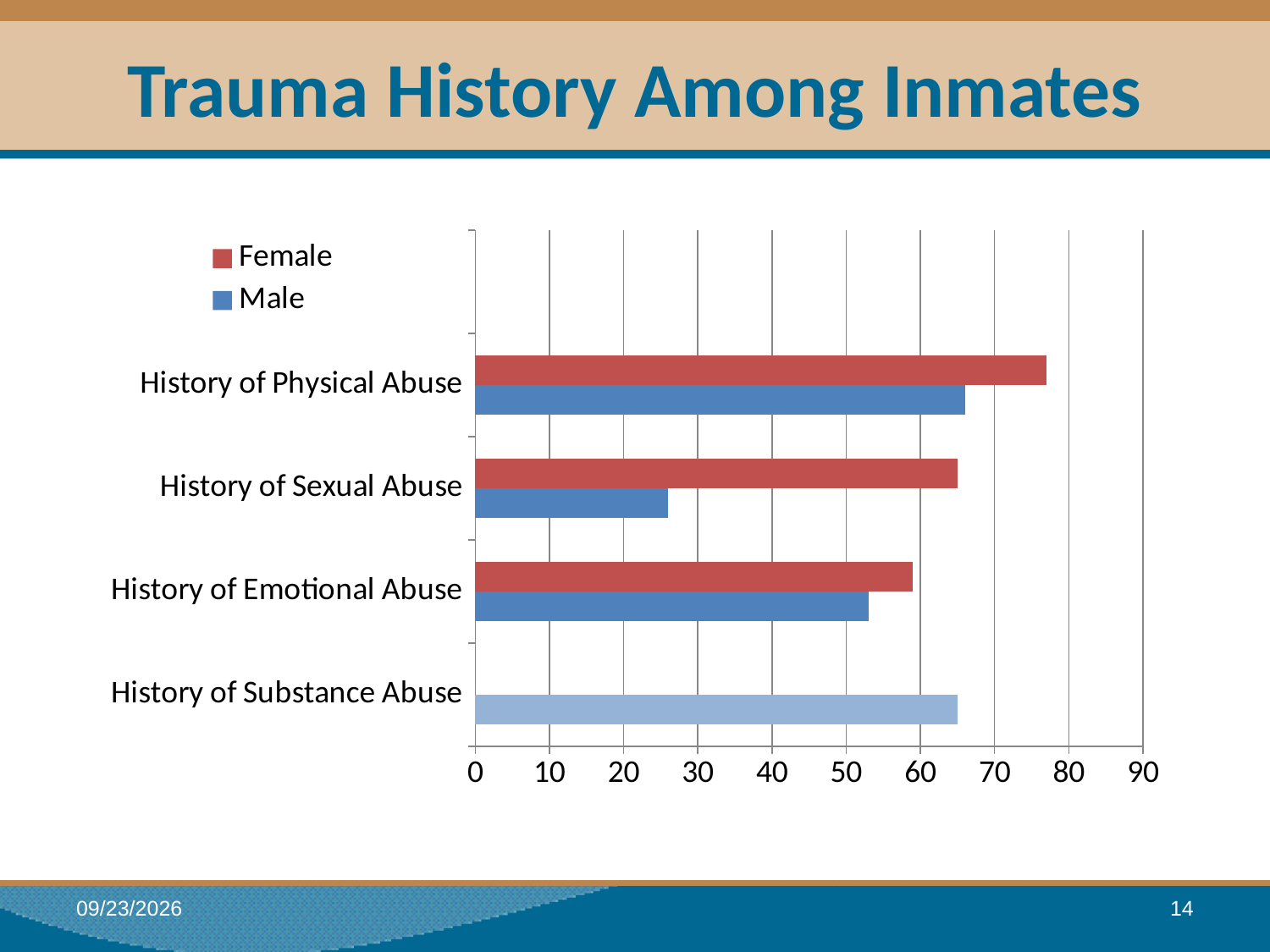
How many series does the legend list? 2 For History of Sexual Abuse, which is larger, the Female value or the Male value? Female Which category has the lowest Male value? History of Sexual Abuse Is the Female value for History of Physical Abuse greater or less than 70? greater For History of Physical Abuse, which is larger, the Female value or the Male value? Female What type of chart is shown on the slide? bar chart Which category has the highest Female value? History of Physical Abuse Is the Male value for History of Sexual Abuse greater or less than 30? less What is the title of the slide containing the chart? Trauma History Among Inmates Is the value for History of Substance Abuse greater or less than 60? greater How many categories are shown on the chart? 4